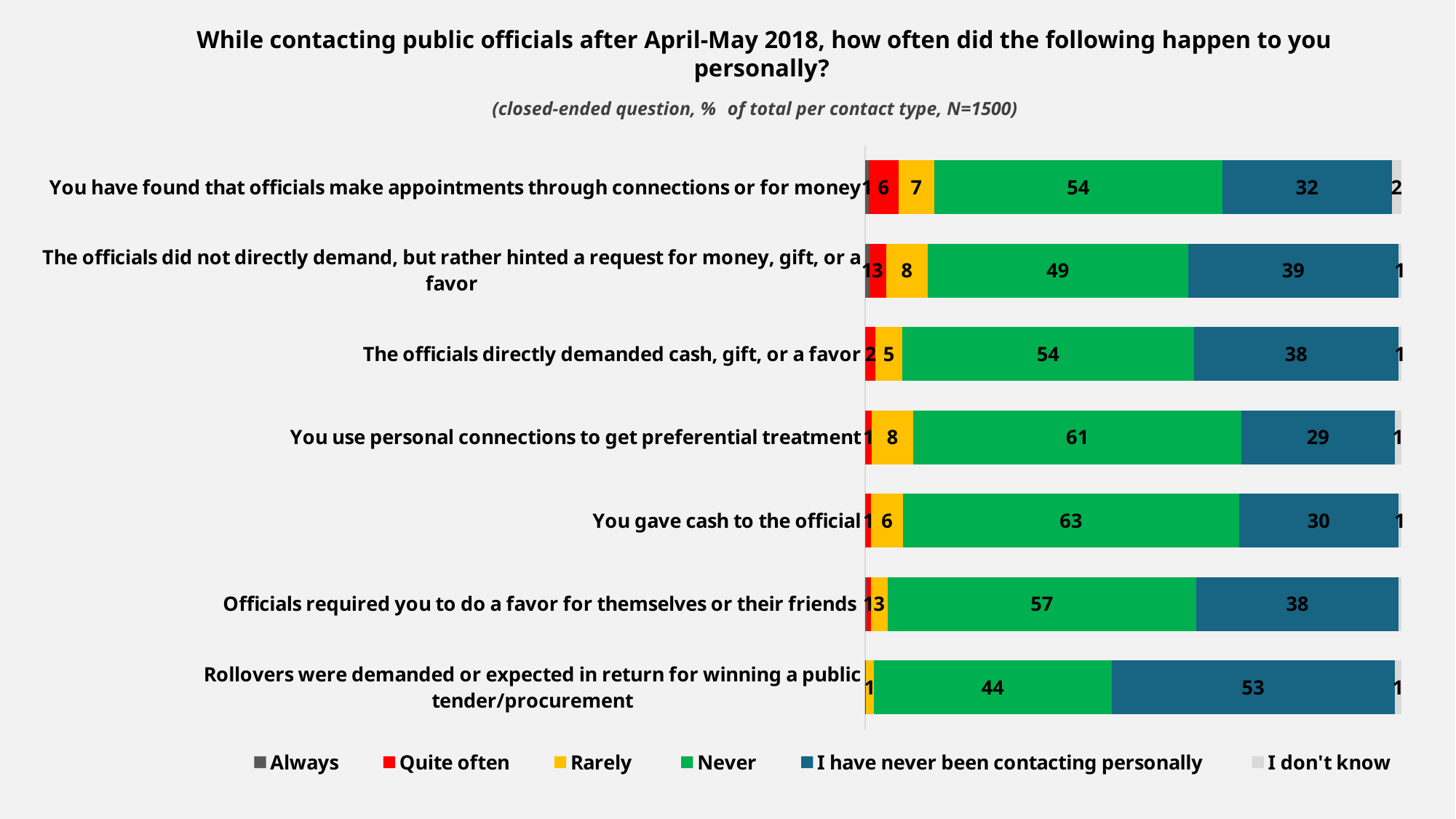
Which statement has the lowest "I have never been contacting personally" percentage? You use personal connections to get preferential treatment Which statement has the highest "Never" percentage? You gave cash to the official How many response categories does the legend list? 6 What percentage answered "Rarely" for "You use personal connections to get preferential treatment"? 8 Which statement has the lowest "Never" percentage? Rollovers were demanded or expected in return for winning a public tender/procurement How many statements (bars) are shown in the chart? 7 What percentage answered "Never" for "You gave cash to the official"? 63 What is the difference between the "Never" percentage for "You gave cash to the official" and for "Rollovers were demanded or expected in return for winning a public tender/procurement"? 19 What type of chart is shown on the slide? Stacked bar chart Which has a larger "Never" percentage: "You use personal connections to get preferential treatment" or "The officials directly demanded cash, gift, or a favor"? You use personal connections to get preferential treatment What percentage answered "I have never been contacting personally" for "Rollovers were demanded or expected in return for winning a public tender/procurement"? 53 What percentage answered "Never" for "The officials did not directly demand, but rather hinted a request for money, gift, or a favor"? 49